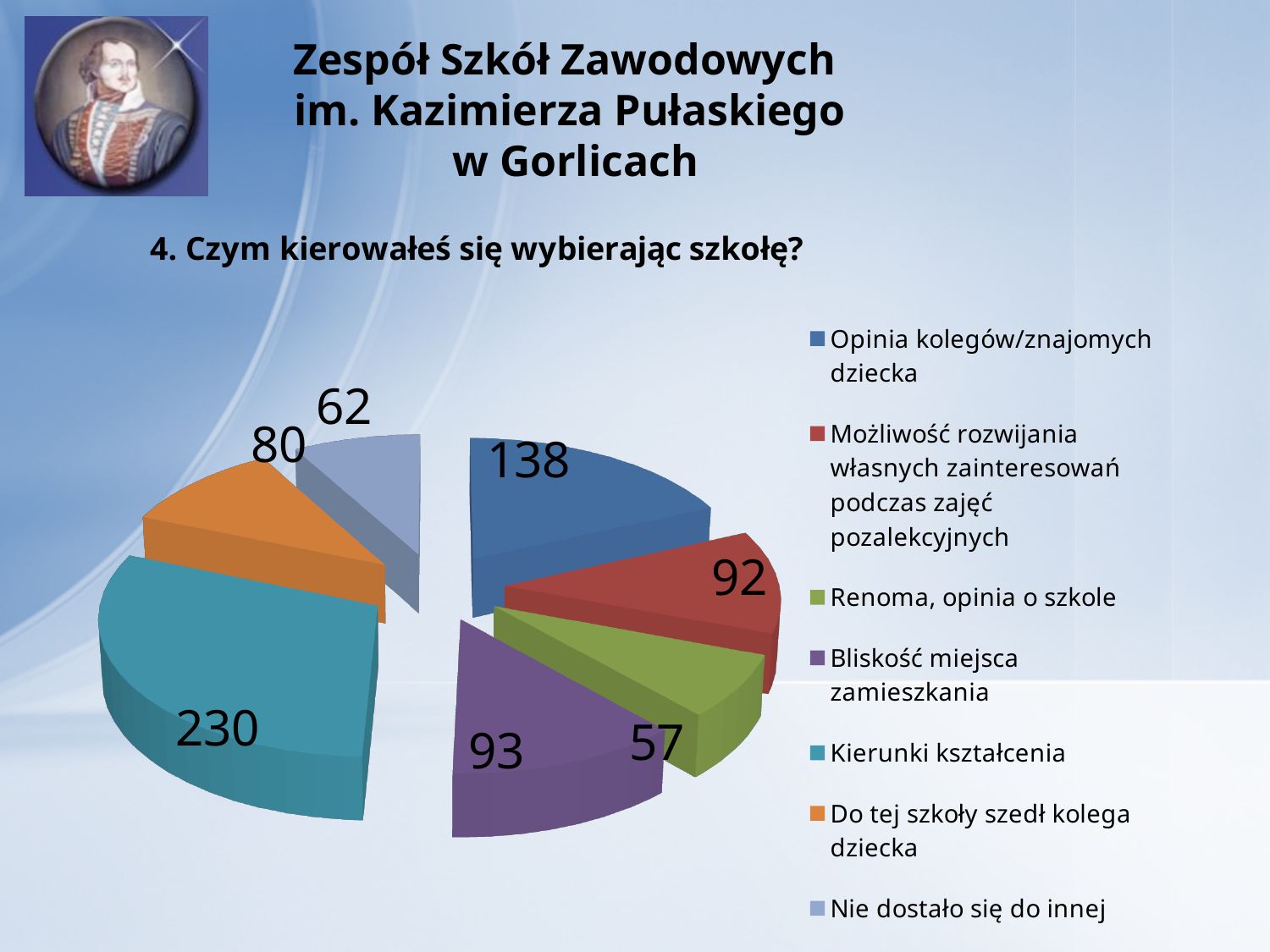
What is the question shown above the chart? 4. Czym kierowałeś się wybierając szkołę? What is the difference between the values for "Kierunki kształcenia" and "Opinia kolegów/znajomych dziecka"? 92 What is the value for "Kierunki kształcenia"? 230 What is the value for "Renoma, opinia o szkole"? 57 Which category has the smallest slice? Renoma, opinia o szkole How many categories does the pie chart have? 7 Which is larger, the value for "Bliskość miejsca zamieszkania" or the value for "Renoma, opinia o szkole"? Bliskość miejsca zamieszkania What type of chart is shown on the slide? Pie chart Which category has the largest slice? Kierunki kształcenia What is the value for "Nie dostało się do innej"? 62 What is the difference between the values for "Do tej szkoły szedł kolega dziecka" and "Nie dostało się do innej"? 18 What is the value for "Opinia kolegów/znajomych dziecka"? 138